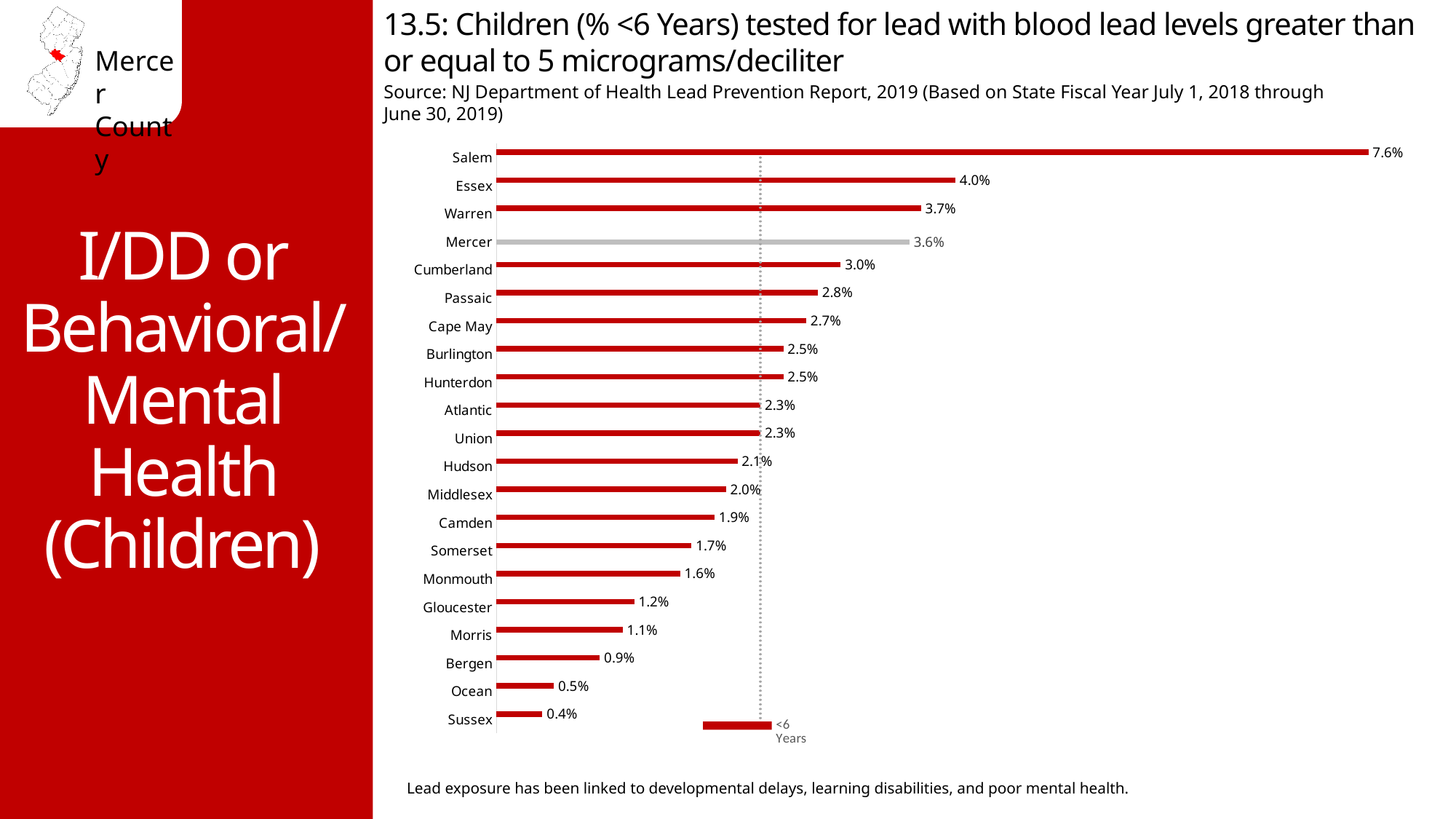
What is the difference between the values for Salem and Essex? 3.6% What is the value for Mercer? 3.6% How many counties are shown in the chart? 21 What is the value for Camden? 1.9% Which county has the highest value? Salem Which county has the lowest value? Sussex Which is larger, the value for Warren or the value for Cumberland? Warren Which is larger, the value for Bergen or the value for Gloucester? Gloucester What is the difference between the values for Mercer and Sussex? 3.2% What kind of chart is shown on the slide? Bar chart How many series does the legend list? 1 What is the value for Salem? 7.6%